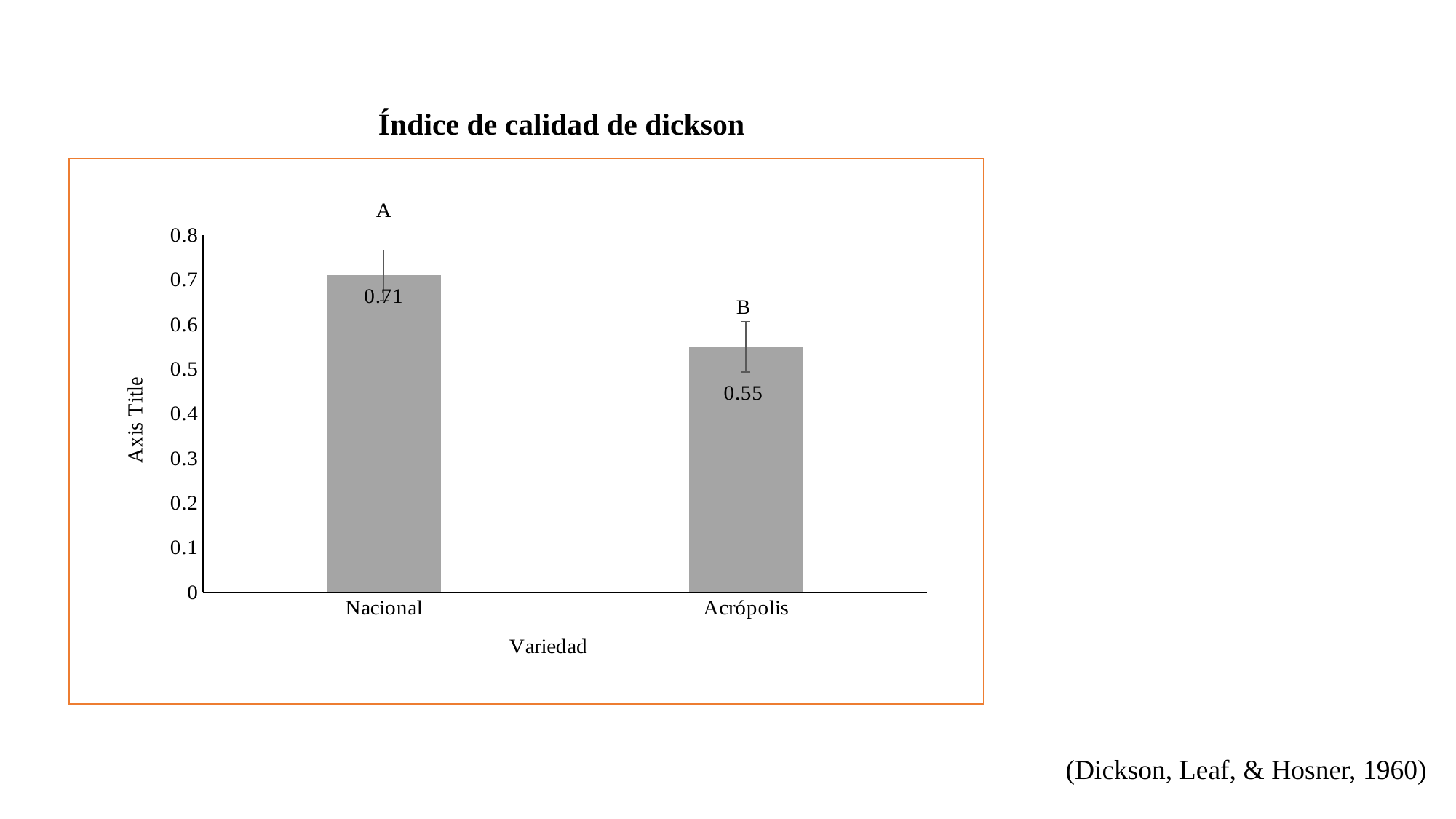
What is the value for Acrópolis? 0.55 Which variety has the highest value? Nacional What is the difference between the values for Nacional and Acrópolis? 0.16 How many varieties are shown on the x axis? 2 What is the title of the chart? Índice de calidad de dickson Is the value for Nacional greater or less than 0.6? greater Which is larger, the value for Nacional or the value for Acrópolis? Nacional Which variety has the lowest value? Acrópolis What kind of chart is shown? bar chart What is the label of the x axis? Variedad What is the value for Nacional? 0.71 Is the value for Acrópolis greater or less than 0.6? less